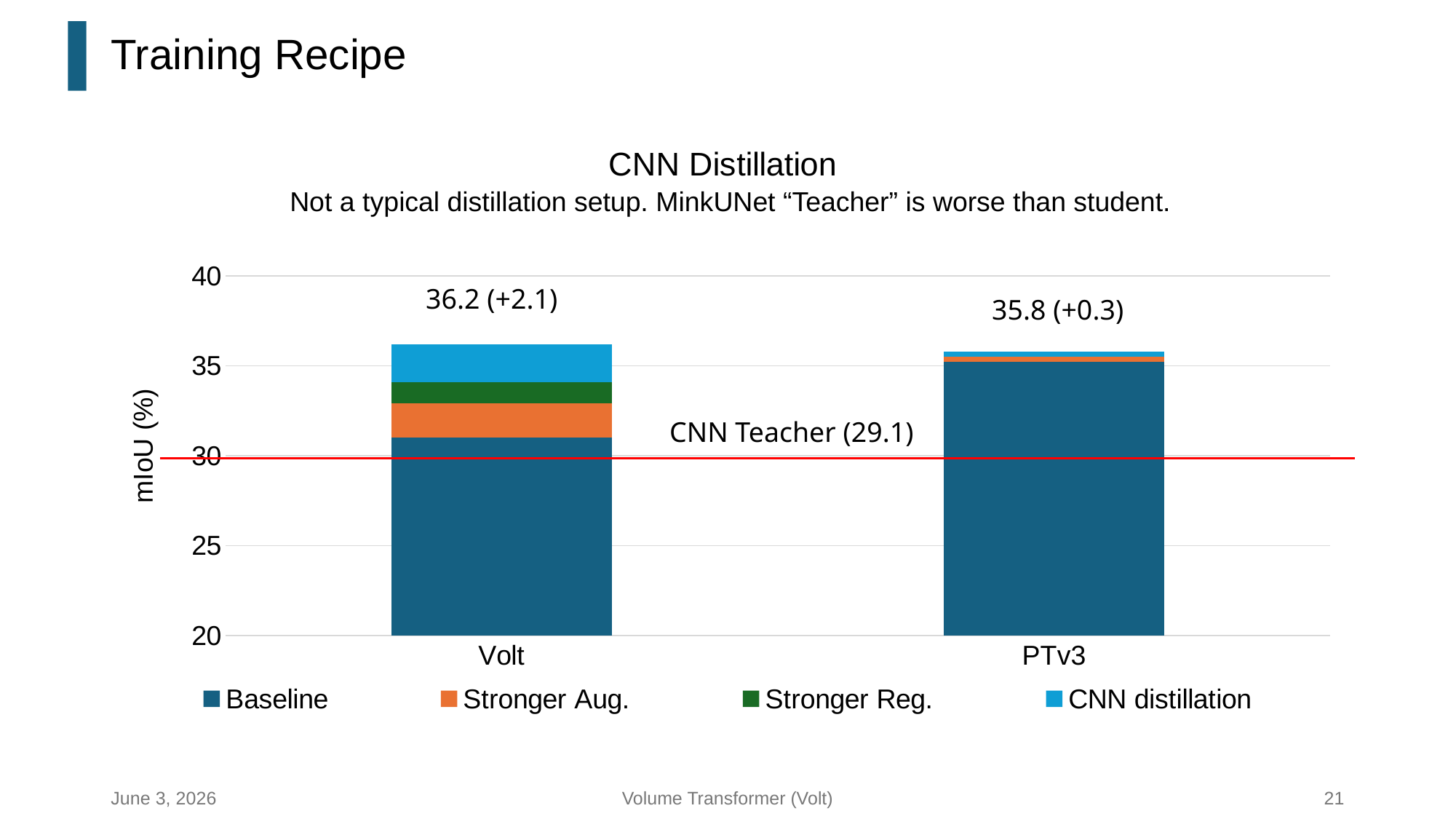
What kind of chart is shown on the slide? Stacked bar chart What gain is shown in parentheses next to the Volt total? +2.1 Is the Baseline value for Volt greater or less than 30? greater Which category has the lowest labelled total? PTv3 What value is given for the CNN Teacher reference line? 29.1 How many categories are shown on the x axis of the chart? 2 What gain is shown in parentheses next to the PTv3 total? +0.3 What is the difference between the labelled totals for Volt and PTv3? 0.4 Which bar has the higher total, Volt or PTv3? Volt What is the total mIoU labelled for the Volt bar? 36.2 What is the total mIoU labelled for the PTv3 bar? 35.8 How many series does the chart legend list? 4